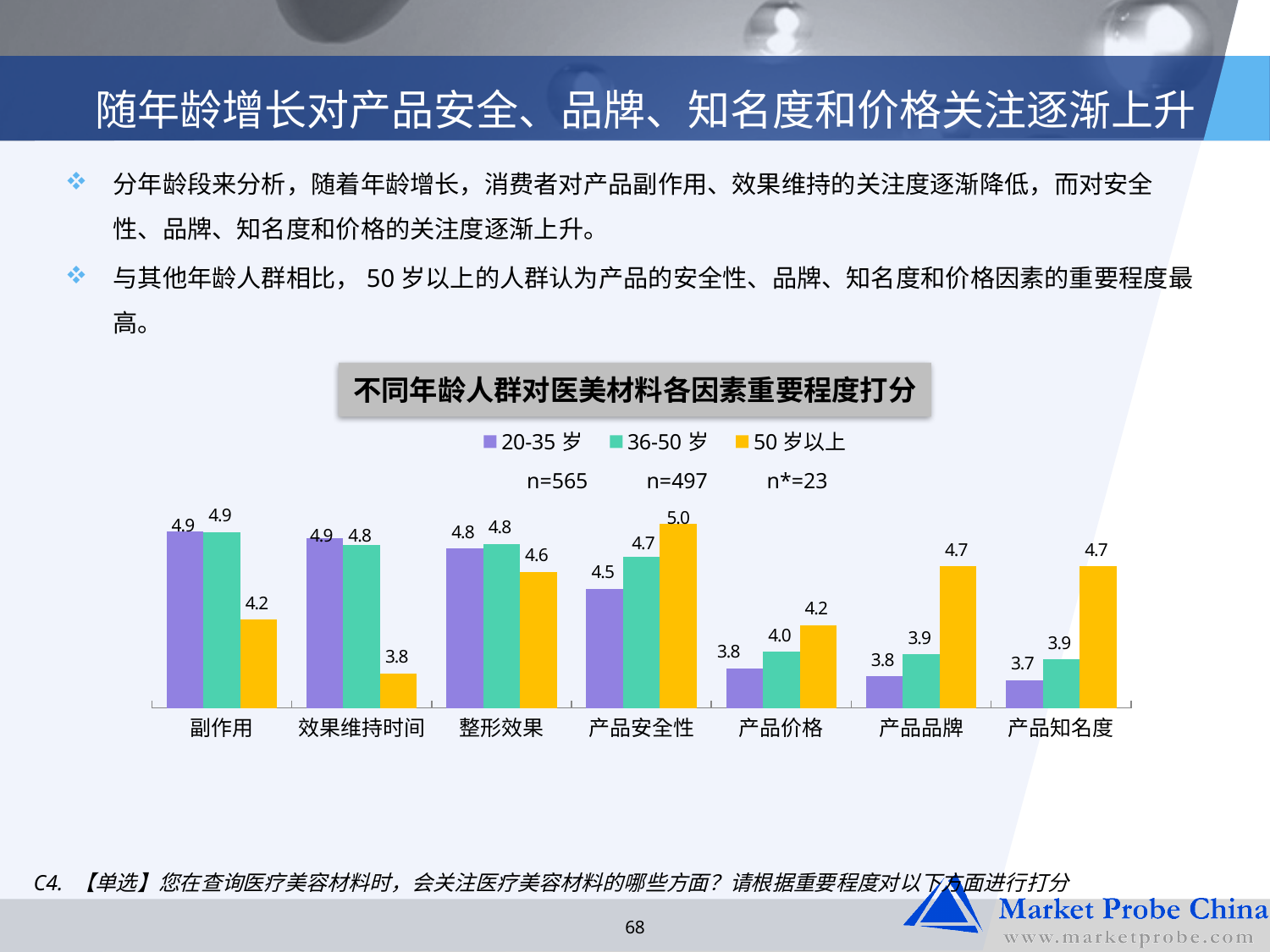
What is the value for 36-50 岁 in the 产品价格 category? 4.0 What is the difference between the 20-35 岁 and 50 岁以上 values in the 产品品牌 category? 0.9 What type of chart is shown on the slide? bar chart How many series does the legend list? 3 What is the value for 20-35 岁 in the 产品知名度 category? 3.7 What is the sample size (n) shown for the 36-50 岁 group? n=497 How many categories are shown on the x axis? 7 In the 副作用 category, which is larger: the value for 36-50 岁 or the value for 50 岁以上? 36-50 岁 What is the value for 50 岁以上 in the 产品安全性 category? 5.0 What is the title of the chart? 不同年龄人群对医美材料各因素重要程度打分 Which category has the highest value for the 50 岁以上 series? 产品安全性 Which category has the lowest value for the 50 岁以上 series? 效果维持时间